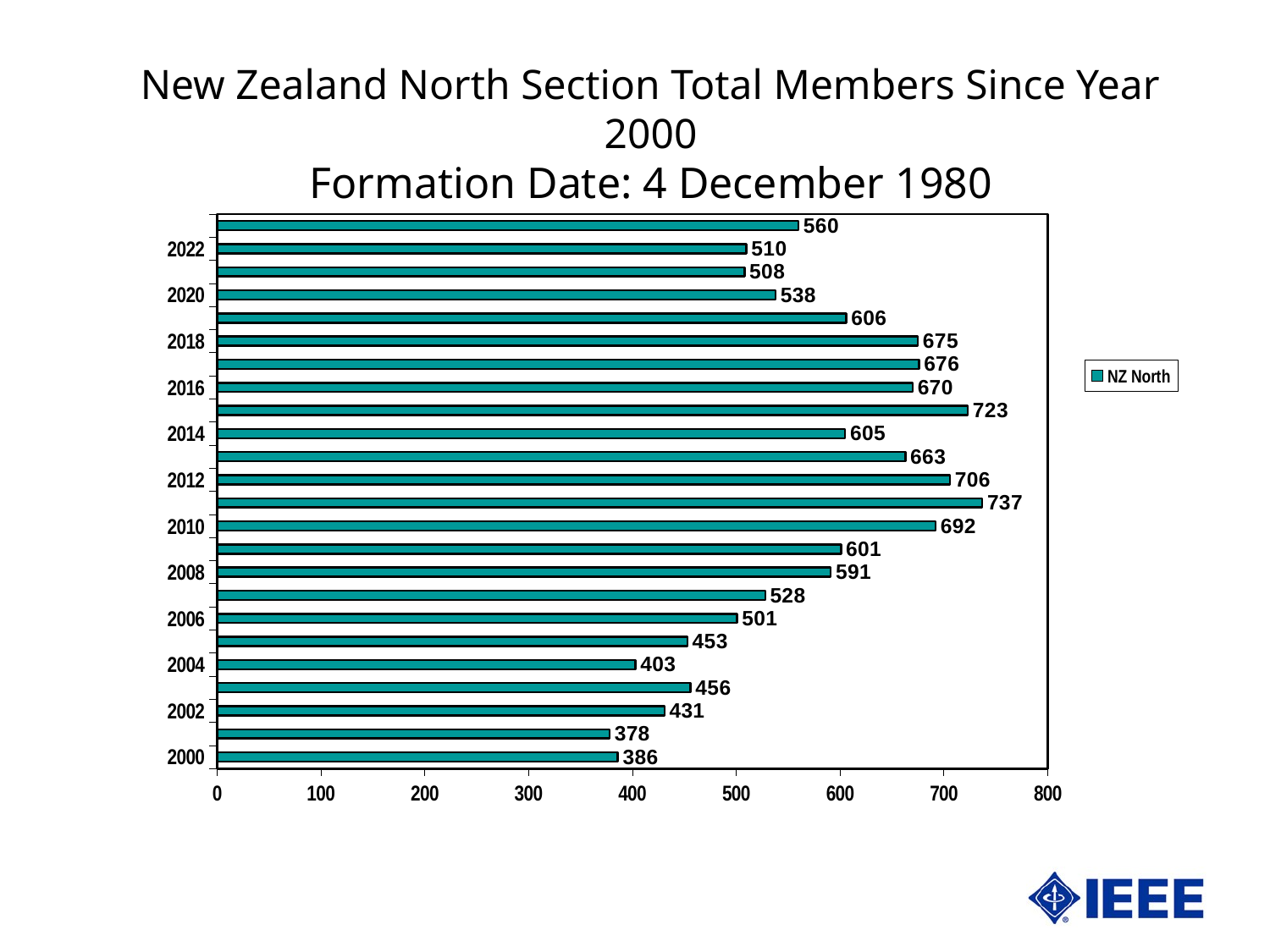
What is the difference between the values for 2010 and 2000? 306 How many series does the legend list? 1 What is the value for 2016? 670 What series name appears in the legend? NZ North What kind of chart is shown? bar chart What is the value for 2000? 386 What is the highest value shown on the chart? 737 What is the value for 2020? 538 Which is larger, the value for 2012 or the value for 2014? 2012 What is the lowest value shown on the chart? 378 How many bars are plotted on the chart? 24 What is the value for 2010? 692